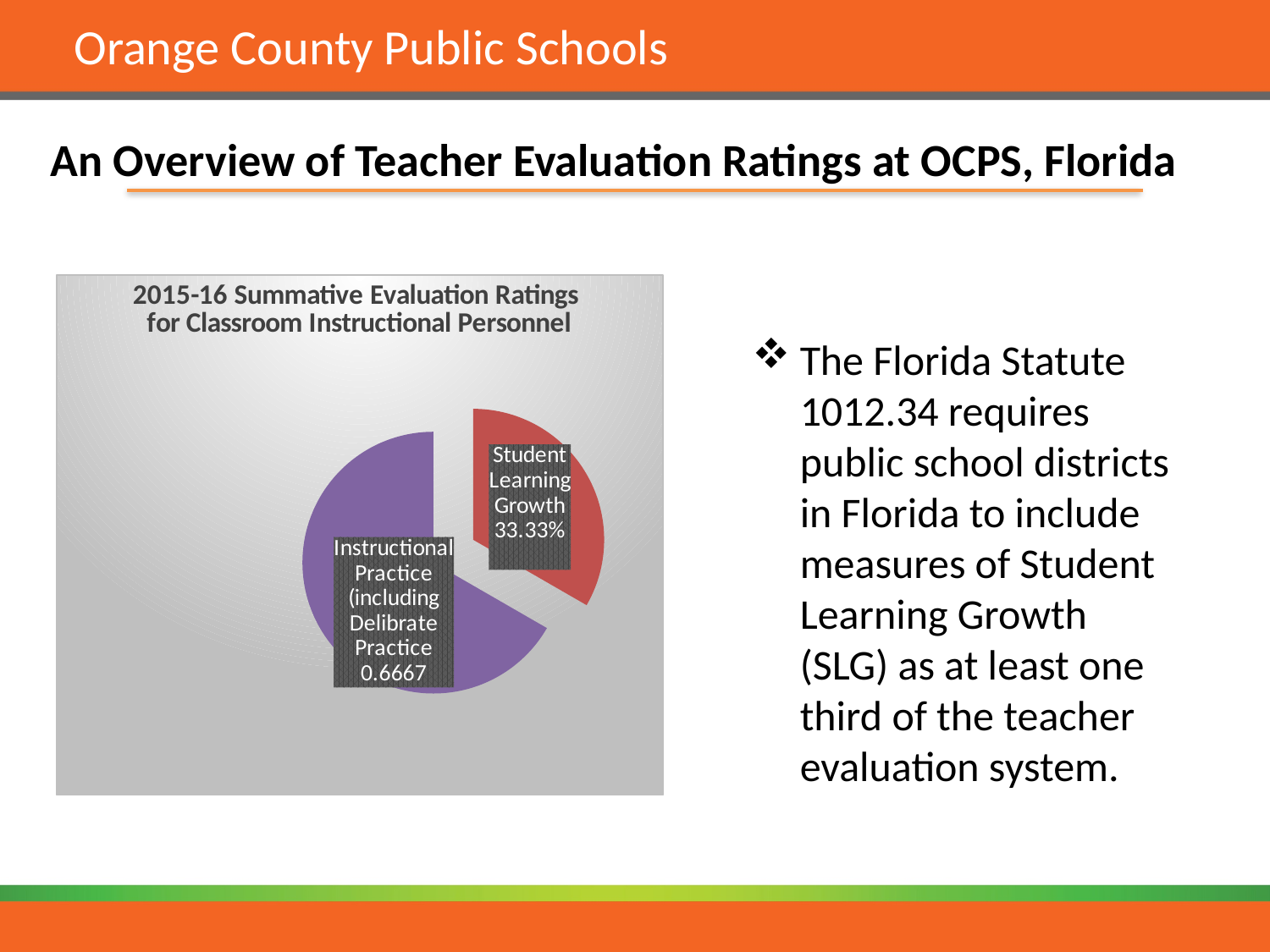
How many slices does the pie chart have? 2 Which slice of the pie chart is the smallest? Student Learning Growth Which is larger: the Student Learning Growth slice or the Instructional Practice slice? Instructional Practice What colour is the Student Learning Growth slice? red What kind of chart is shown on the slide? pie chart What value is shown for the Instructional Practice (including Delibrate Practice) slice? 0.6667 What share of the pie does Student Learning Growth represent? 33.33% Which slice of the pie chart is the largest? Instructional Practice (including Delibrate Practice) What value is shown for the Student Learning Growth slice? 33.33% What is the title of the chart? 2015-16 Summative Evaluation Ratings for Classroom Instructional Personnel